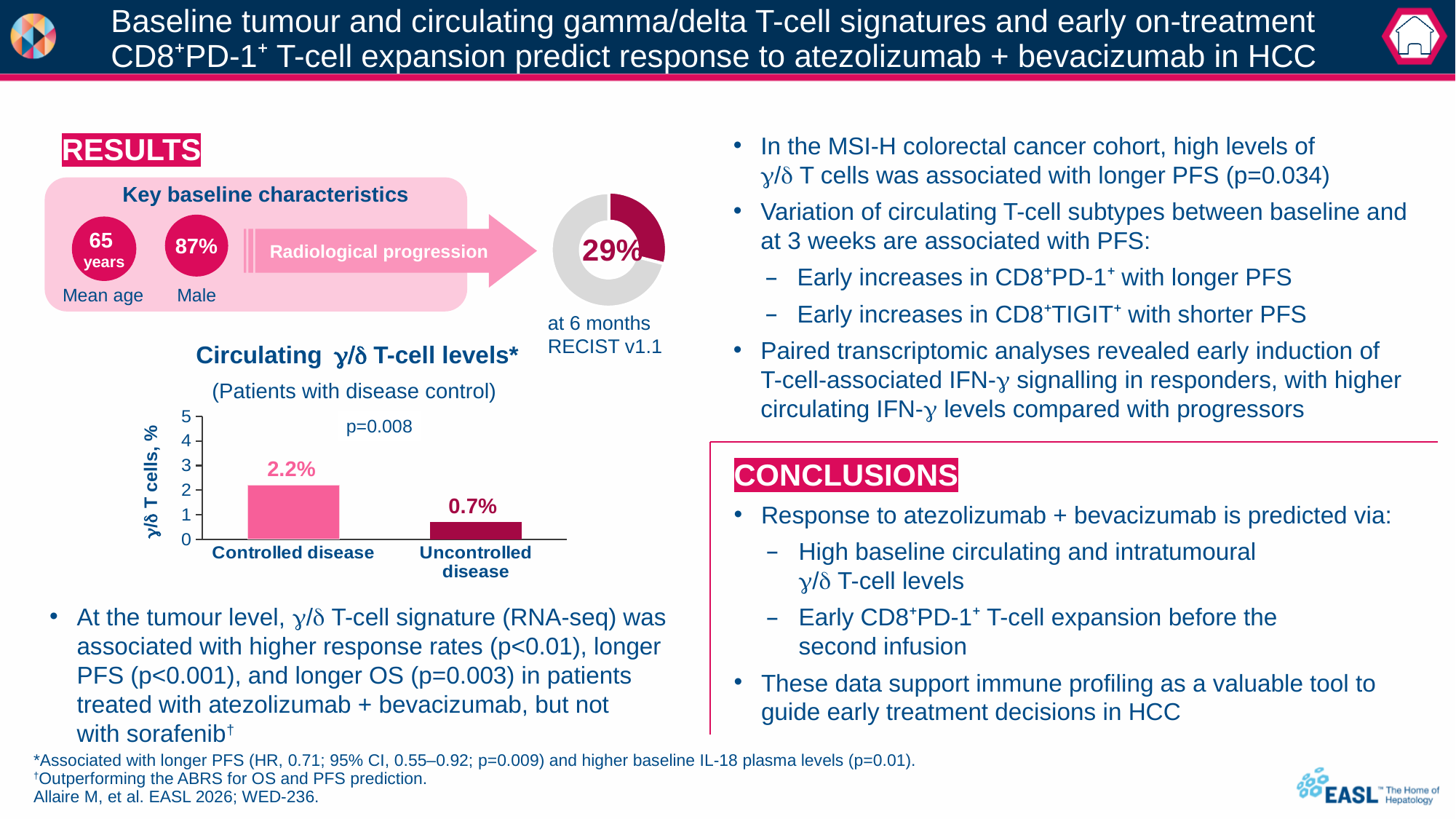
How many categories are shown in the 'Circulating γ/δ T-cell levels' bar chart? 2 What p-value is shown on the 'Circulating γ/δ T-cell levels' bar chart? p=0.008 In the 'Circulating γ/δ T-cell levels' bar chart, what is the value for Controlled disease? 2.2% In the 'Circulating γ/δ T-cell levels' bar chart, is the value for Uncontrolled disease greater or less than 1? less What kind of chart is the 'Circulating γ/δ T-cell levels' chart? Bar chart In the donut chart next to 'Radiological progression', what percentage is shown for radiological progression at 6 months? 29% In the 'Circulating γ/δ T-cell levels' bar chart, what is the value for Uncontrolled disease? 0.7% What is the y-axis label of the 'Circulating γ/δ T-cell levels' bar chart? γ/δ T cells, % In the 'Circulating γ/δ T-cell levels' bar chart, what is the difference between the Controlled disease and Uncontrolled disease values? 1.5% In the 'Circulating γ/δ T-cell levels' bar chart, which category has the lowest value? Uncontrolled disease In the 'Circulating γ/δ T-cell levels' bar chart, which category has the highest value? Controlled disease In the 'Circulating γ/δ T-cell levels' bar chart, is the value for Controlled disease greater or less than 2? greater